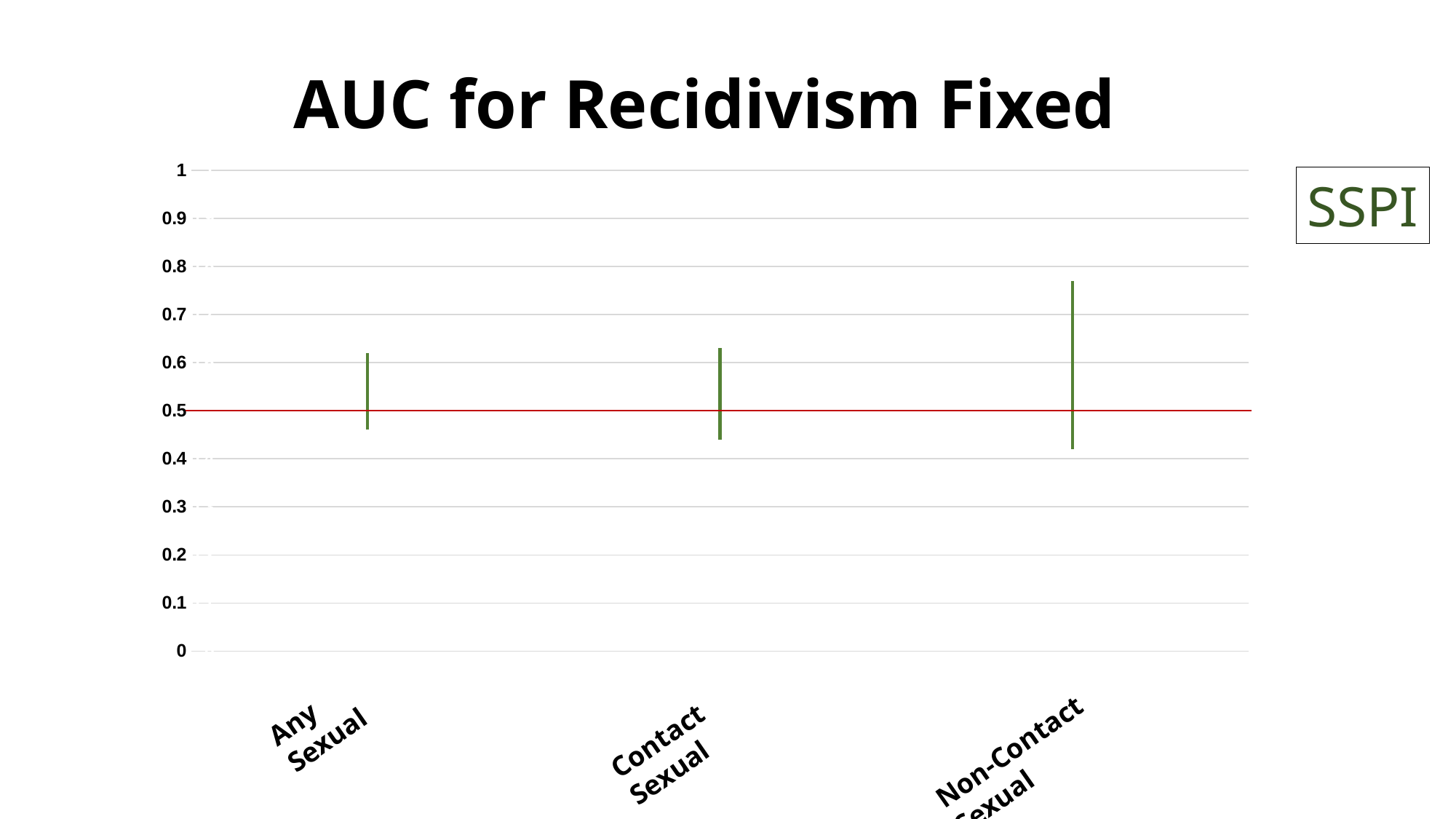
Is the upper end of the range for Any Sexual greater or less than 0.7? less At what value on the y axis is the red horizontal reference line drawn? 0.5 Which category has the widest range (longest vertical line)? Non-Contact Sexual Is the lower end of the range for Non-Contact Sexual greater or less than 0.5? less What is the title of the chart? AUC for Recidivism Fixed What is the maximum value shown on the y axis? 1 How many categories are shown on the x axis? 3 Is the upper end of the range for Non-Contact Sexual greater or less than 0.7? greater Is the upper end of the range for Non-Contact Sexual larger than the upper end of the range for Contact Sexual? Yes Which category has the highest upper end of its range? Non-Contact Sexual